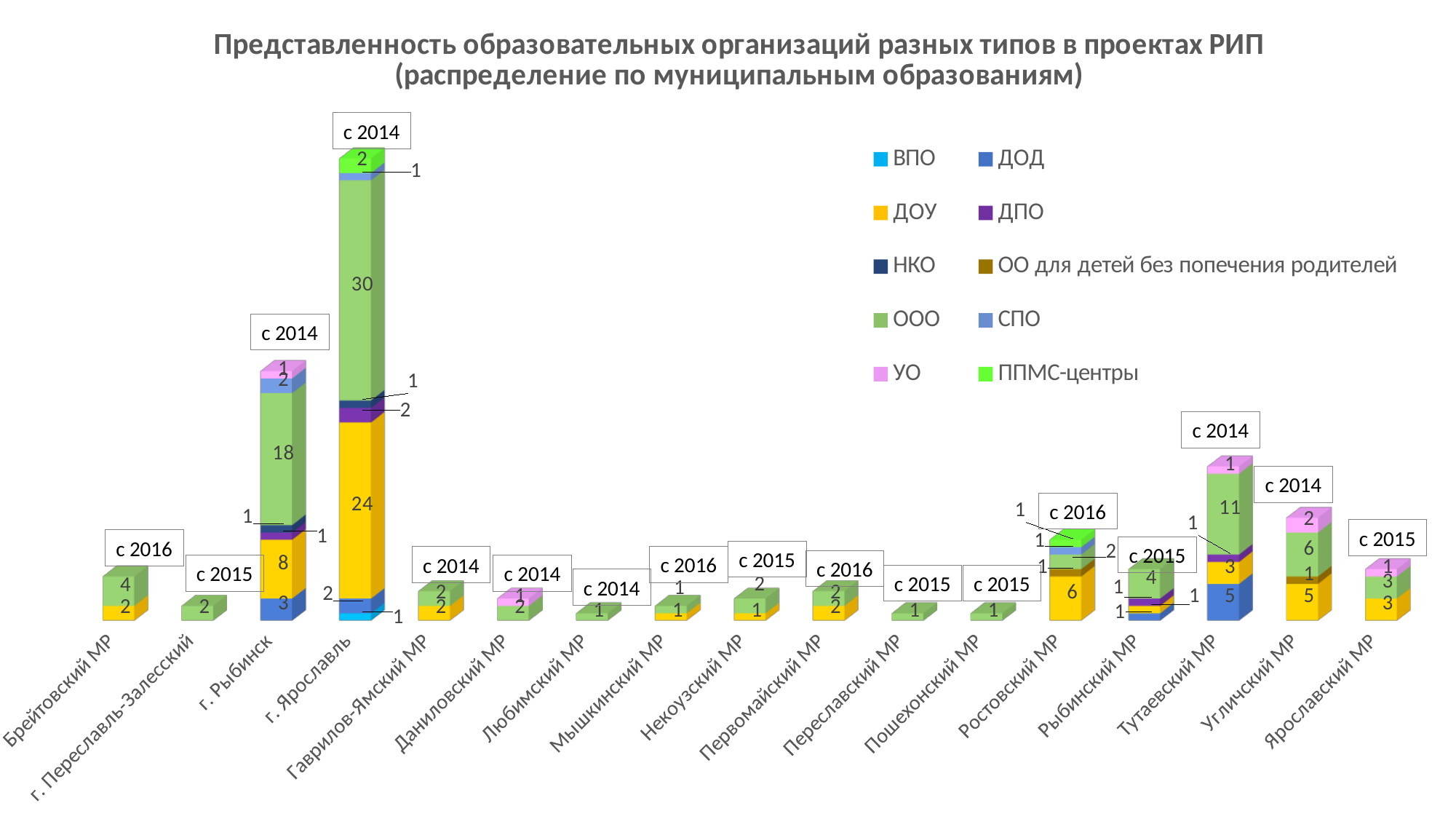
How many series does the legend list? 10 What is the total of the stacked bar for Брейтовский МР? 6 What is the value of ДОД for Тутаевский МР? 5 What is the value of ООО for г. Ярославль? 30 Which has the larger ДОУ value, Угличский МР or Тутаевский МР? Угличский МР What kind of chart is shown on the slide? bar chart What is the value of ДОУ for г. Рыбинск? 8 What is the value of ООО for Тутаевский МР? 11 What is the difference between the ООО value for г. Ярославль and the ООО value for г. Рыбинск? 12 How many municipalities (categories) are shown along the x axis? 17 What annotation label is shown above the bar for г. Ярославль? с 2014 Which municipality has the tallest stacked bar? г. Ярославль